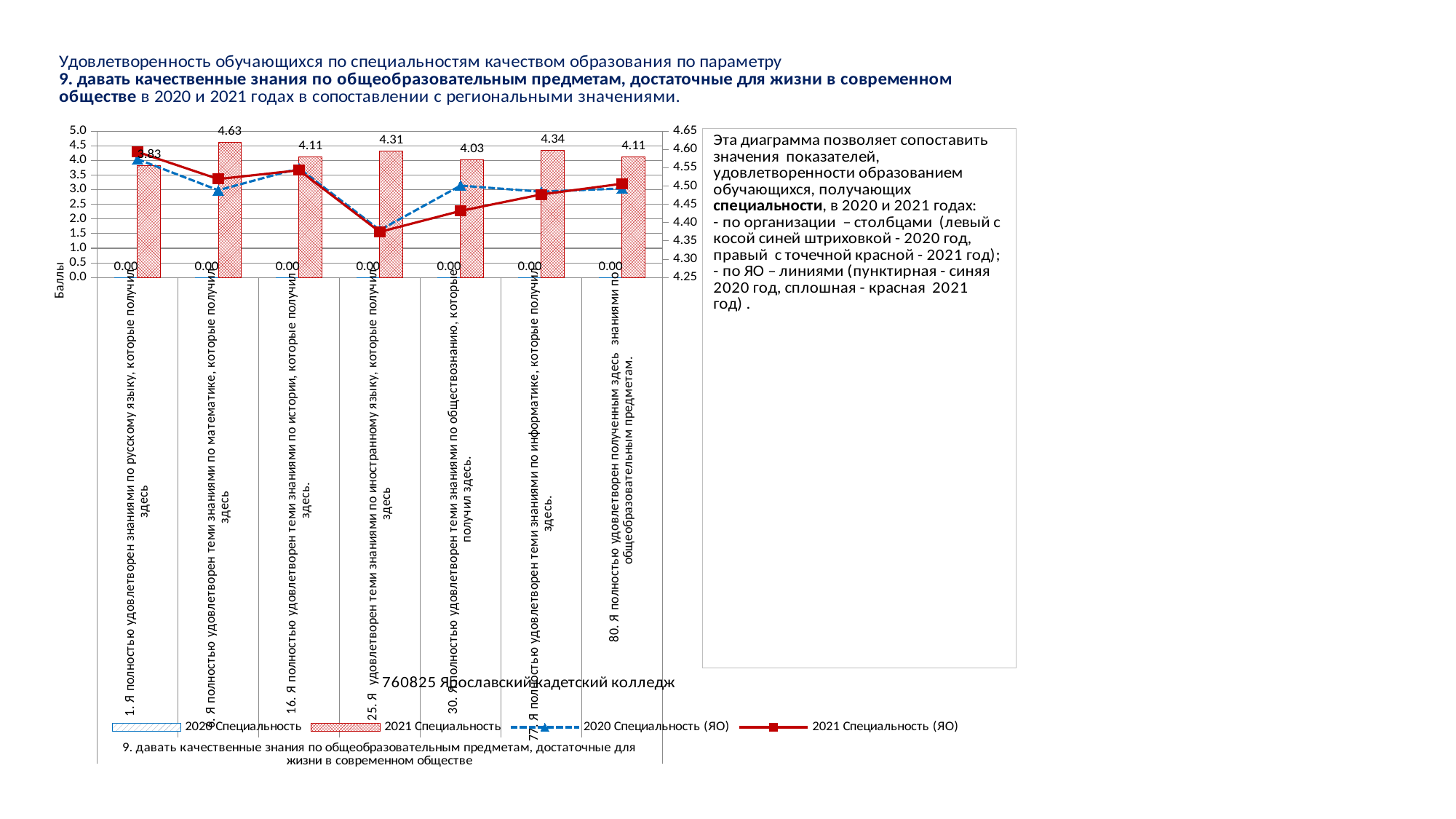
Which category has the highest 2021 Специальность value? 6. Я полностью удовлетворен теми знаниями по математике, которые получил здесь What is the 2021 Специальность value for the category about knowledge of mathematics (математике)? 4.63 Which is larger: the 2021 Специальность value for social studies (обществознанию) or for informatics (информатике)? информатике (4.34) What is the 2021 Специальность value for the category about knowledge of informatics (информатике)? 4.34 Which category has the lowest 2021 Специальность value? 1. Я полностью удовлетворен знаниями по русскому языку, которые получил здесь Which legend entry corresponds to the dashed blue line? 2020 Специальность (ЯО) How many categories are shown on the x axis of the chart? 7 How many series does the chart legend list? 4 What is the 2020 Специальность value shown for the category about knowledge of history (истории)? 0.00 What is the difference between the 2021 Специальность values for mathematics (математике) and Russian language (русскому языку)? 0.80 What is the 2021 Специальность value for the category about knowledge of Russian language (русскому языку)? 3.83 What kind of chart is shown on the slide? Combined bar and line chart